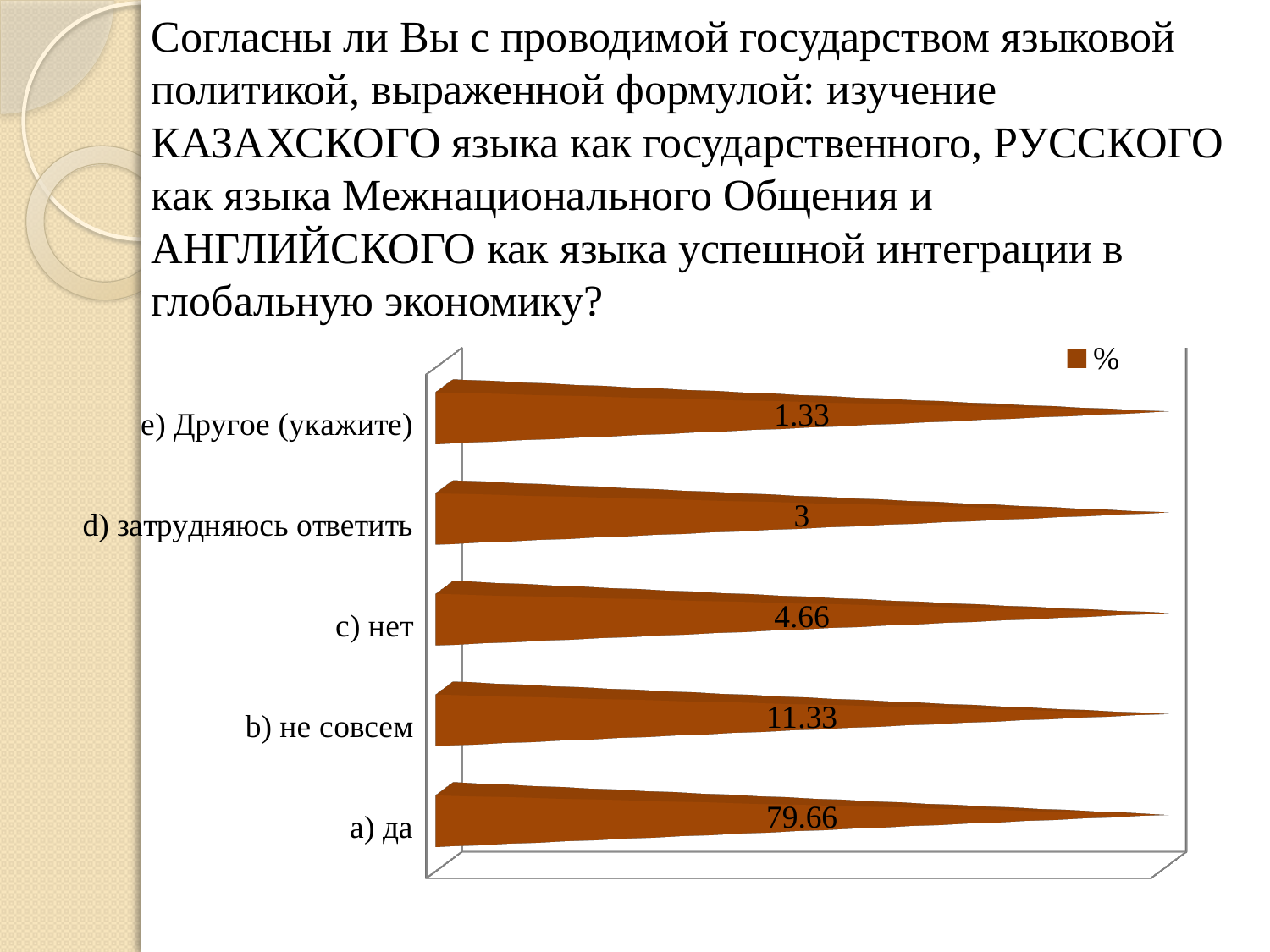
What is the value for "e) Другое (укажите)"? 1.33 Which category has the highest value? a) да What is the value for "a) да"? 79.66 What is the value for "c) нет"? 4.66 Which category has the lowest value? e) Другое (укажите) What is the value for "b) не совсем"? 11.33 How many series does the legend list? 1 What is the legend entry shown for the series? % What is the value for "d) затрудняюсь ответить"? 3 What is the difference between the values for "a) да" and "b) не совсем"? 68.33 How many categories are shown in the chart? 5 Which is larger, the value for "c) нет" or the value for "d) затрудняюсь ответить"? c) нет